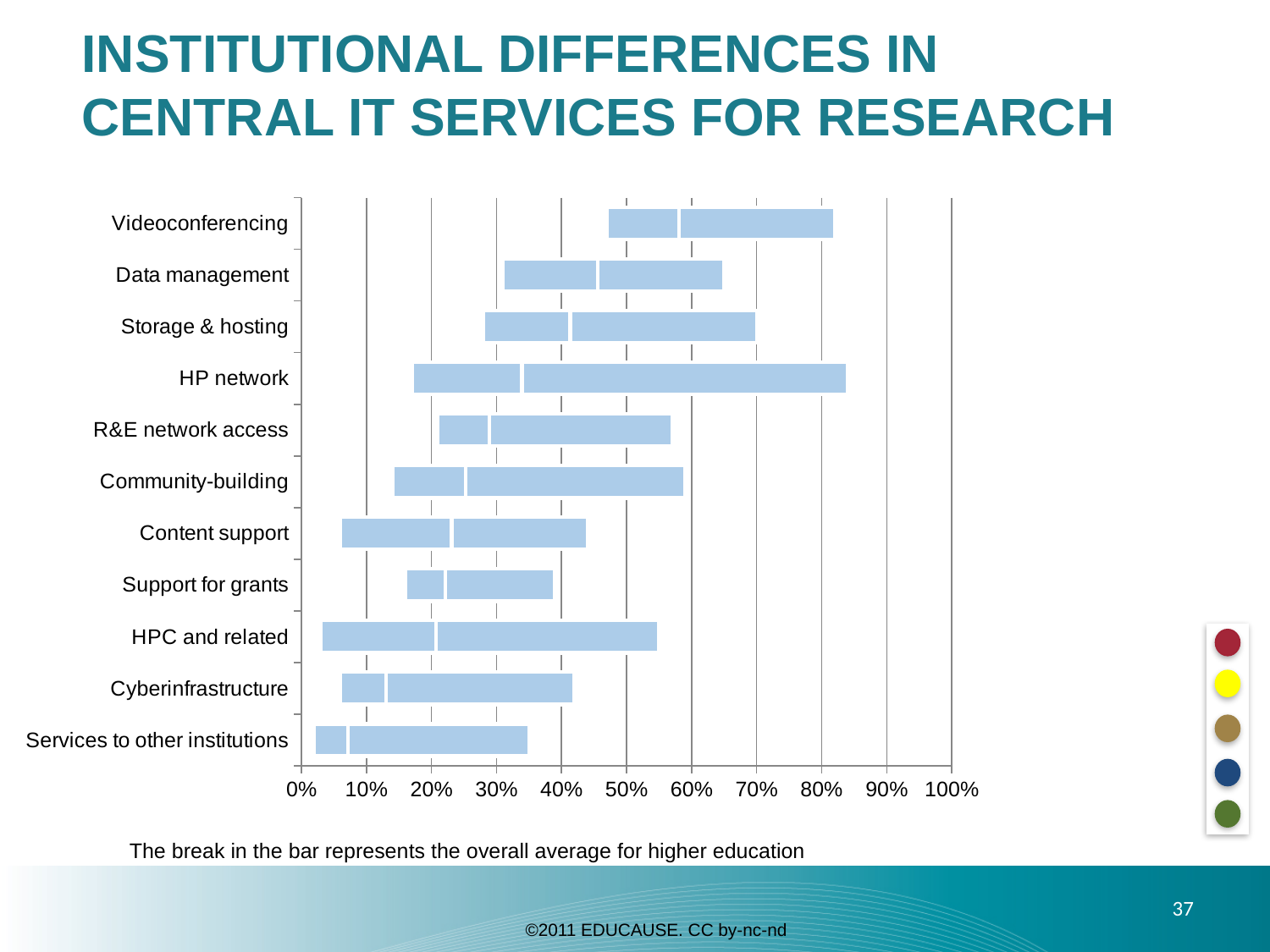
Is the overall average (break) for HP network greater or less than 30%? greater Which has the higher overall average (break): Videoconferencing or Data management? Videoconferencing What kind of chart is shown on the slide? bar chart How many service categories are listed on the chart? 11 Which category has the highest overall average (the break in the bar)? Videoconferencing According to the note below the chart, what does the break in each bar represent? The overall average for higher education Is the upper end of the bar for HPC and related greater or less than 50%? greater Is the overall average (break) for Data management greater or less than 50%? less Which category has the lowest overall average (the break in the bar)? Services to other institutions Which has the higher upper end of its bar: Storage & hosting or R&E network access? Storage & hosting